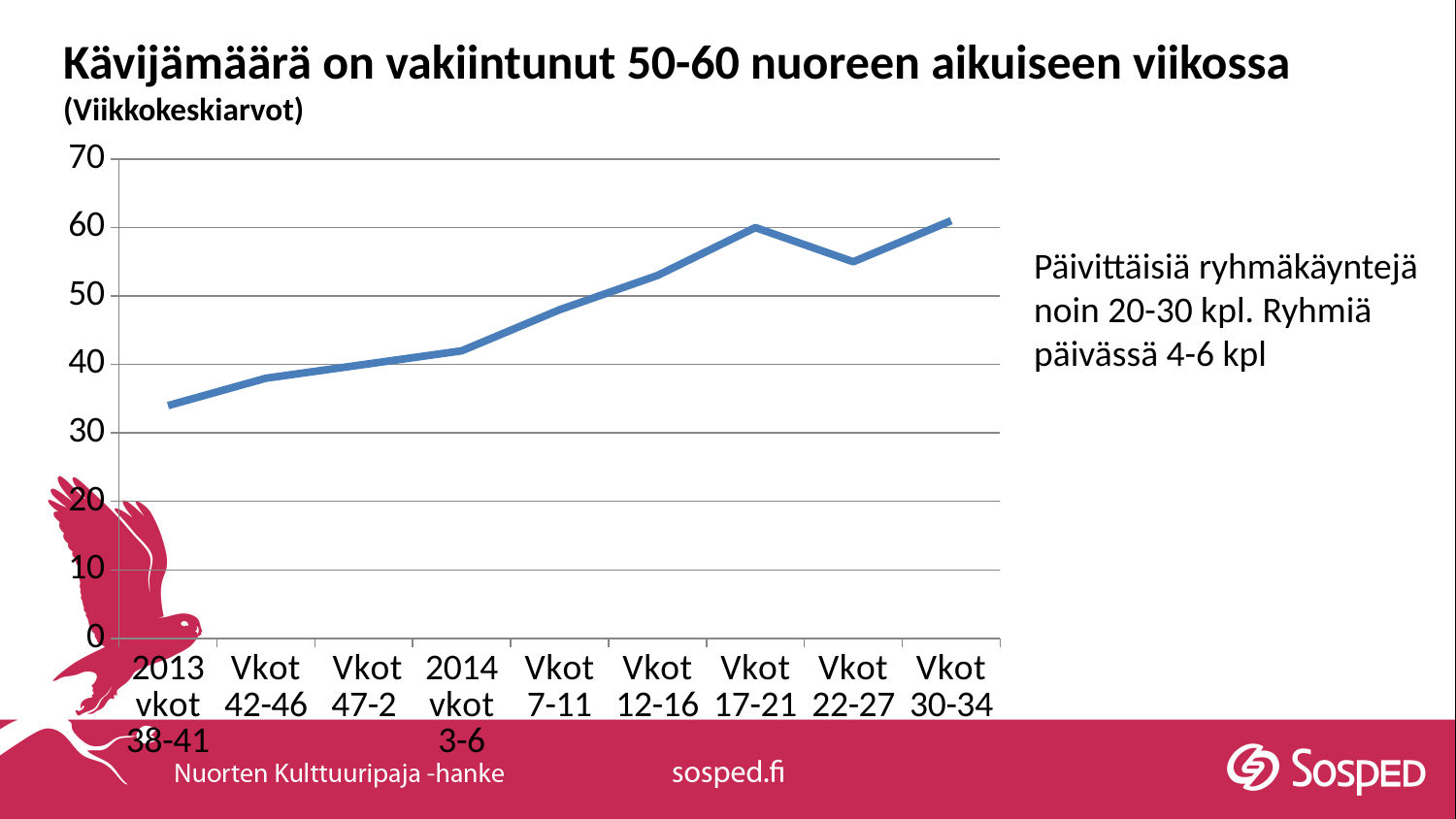
What subtitle appears in parentheses under the slide title? (Viikkokeskiarvot) Is the value for 2013 vkot 38-41 greater or less than 40? less What kind of chart is shown on the slide? line chart Which has a higher value, Vkot 17-21 or Vkot 22-27? Vkot 17-21 Is the value for Vkot 7-11 greater or less than 40? greater Is the value for 2014 vkot 3-6 greater or less than 50? less What is the title of the slide above the chart? Kävijämäärä on vakiintunut 50-60 nuoreen aikuiseen viikossa Which period has the lowest value on the chart? 2013 vkot 38-41 Which has a higher value, Vkot 12-16 or Vkot 42-46? Vkot 12-16 How many data points are plotted on the line chart? 9 Do the values rise or fall from 2013 vkot 38-41 to Vkot 17-21? rise